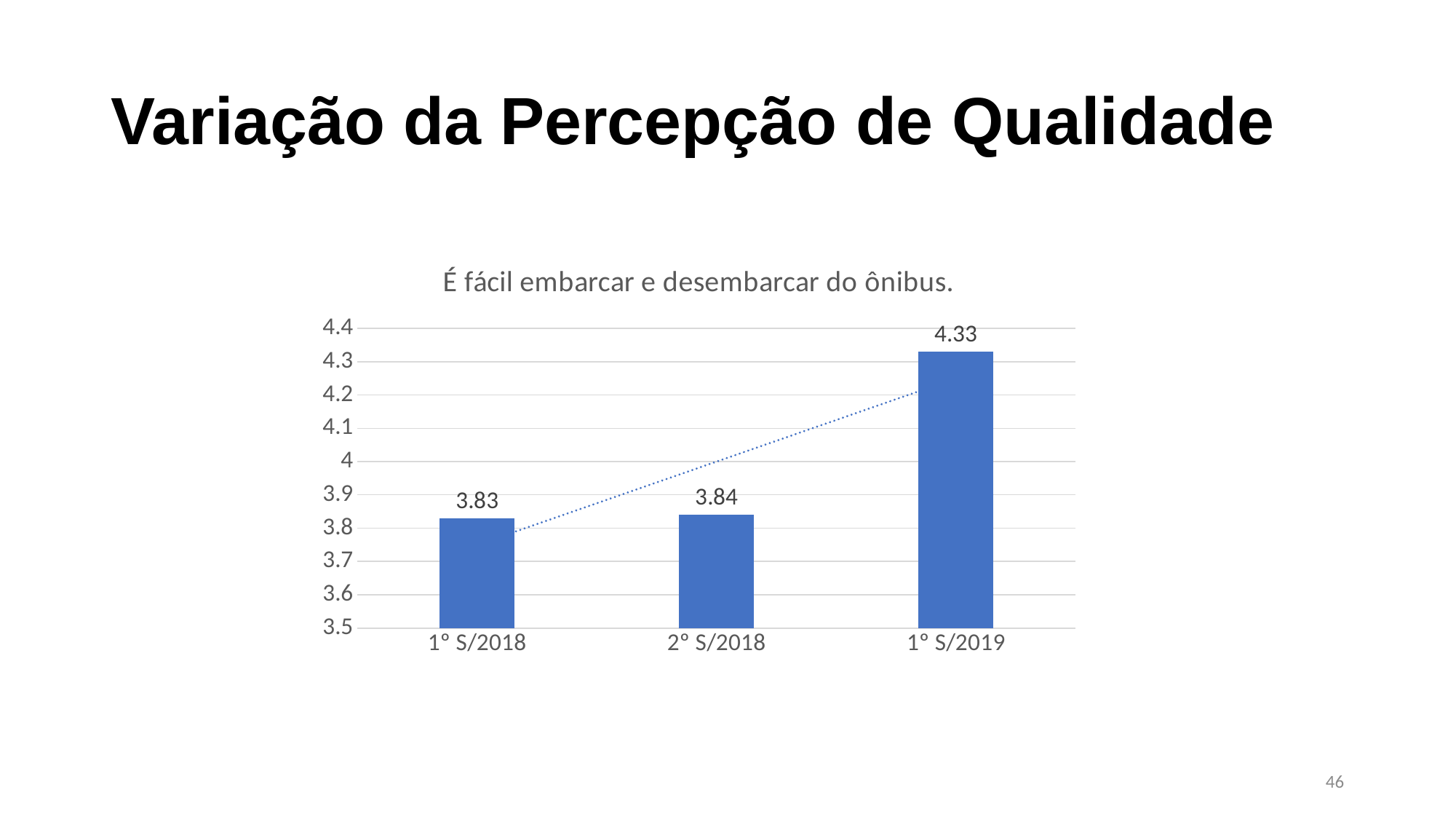
How many periods are shown on the x axis? 3 What kind of chart is shown on the slide? bar chart Is the value for 1° S/2019 greater or less than 4? greater What is the difference between the values for 2° S/2018 and 1° S/2018? 0.01 What is the value for 1° S/2018? 3.83 What is the difference between the values for 1° S/2019 and 2° S/2018? 0.49 What is the title of the chart? É fácil embarcar e desembarcar do ônibus. What is the value for 1° S/2019? 4.33 Which period has the highest value? 1° S/2019 Is the value for 1° S/2018 greater or less than 4? less What is the value for 2° S/2018? 3.84 Which is larger, the value for 1° S/2019 or the value for 1° S/2018? 1° S/2019